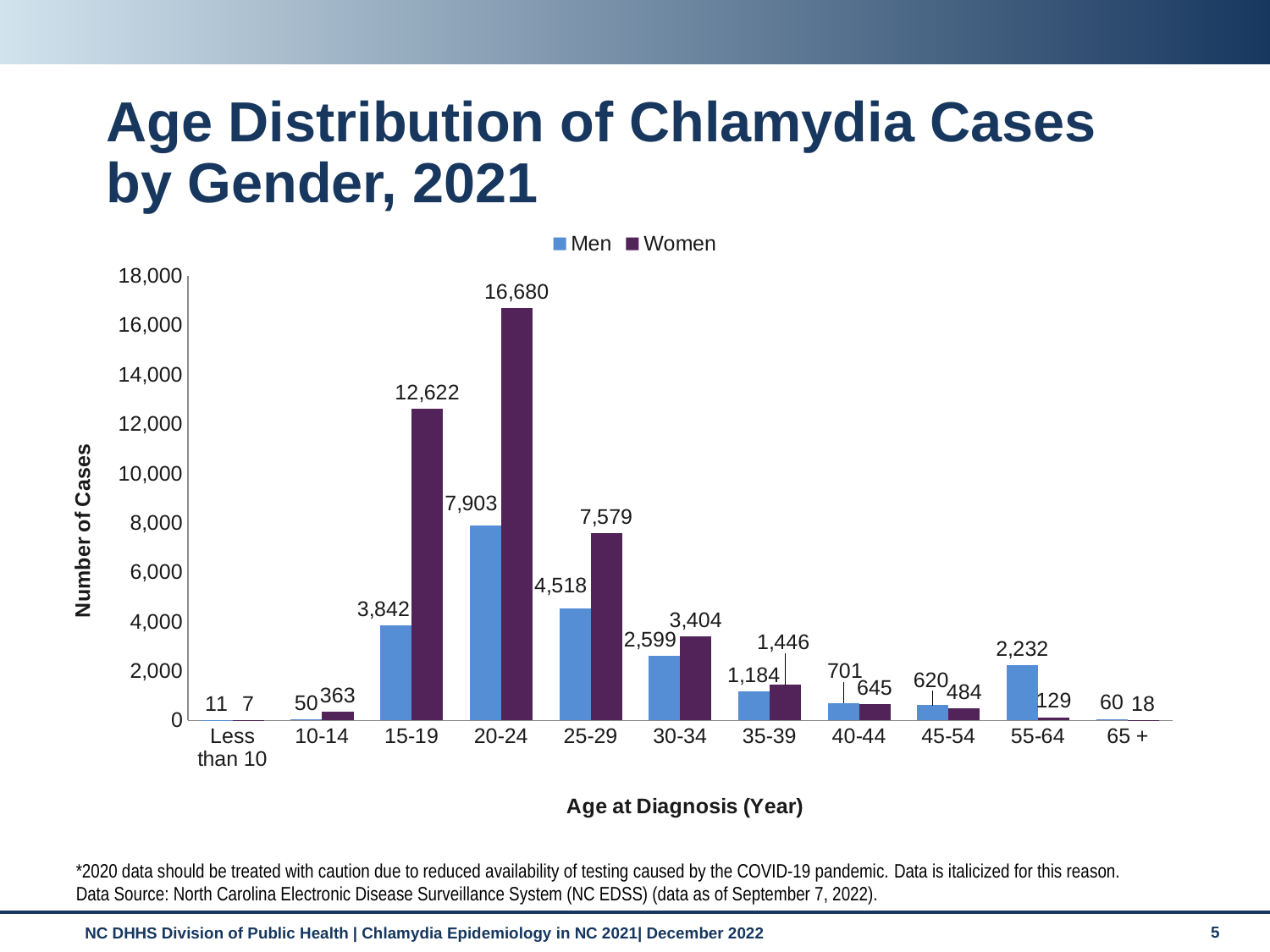
How many age groups are shown on the x axis? 11 In the 45-54 age group, which gender has more cases? Men What is the number of chlamydia cases for women aged 20-24? 16,680 What is the difference between the number of cases for women and men in the 20-24 age group? 8,777 How many series does the legend list? 2 What is the difference between men's and women's cases in the 55-64 age group? 2,103 What is the number of cases for men in the 55-64 age group? 2,232 What type of chart is shown on the slide? Bar chart What is the number of chlamydia cases for men aged 15-19? 3,842 Which age group has the highest number of cases among women? 20-24 Is the number of cases for women aged 15-19 greater or less than 12,000? greater Which age group has the lowest number of cases among men? Less than 10